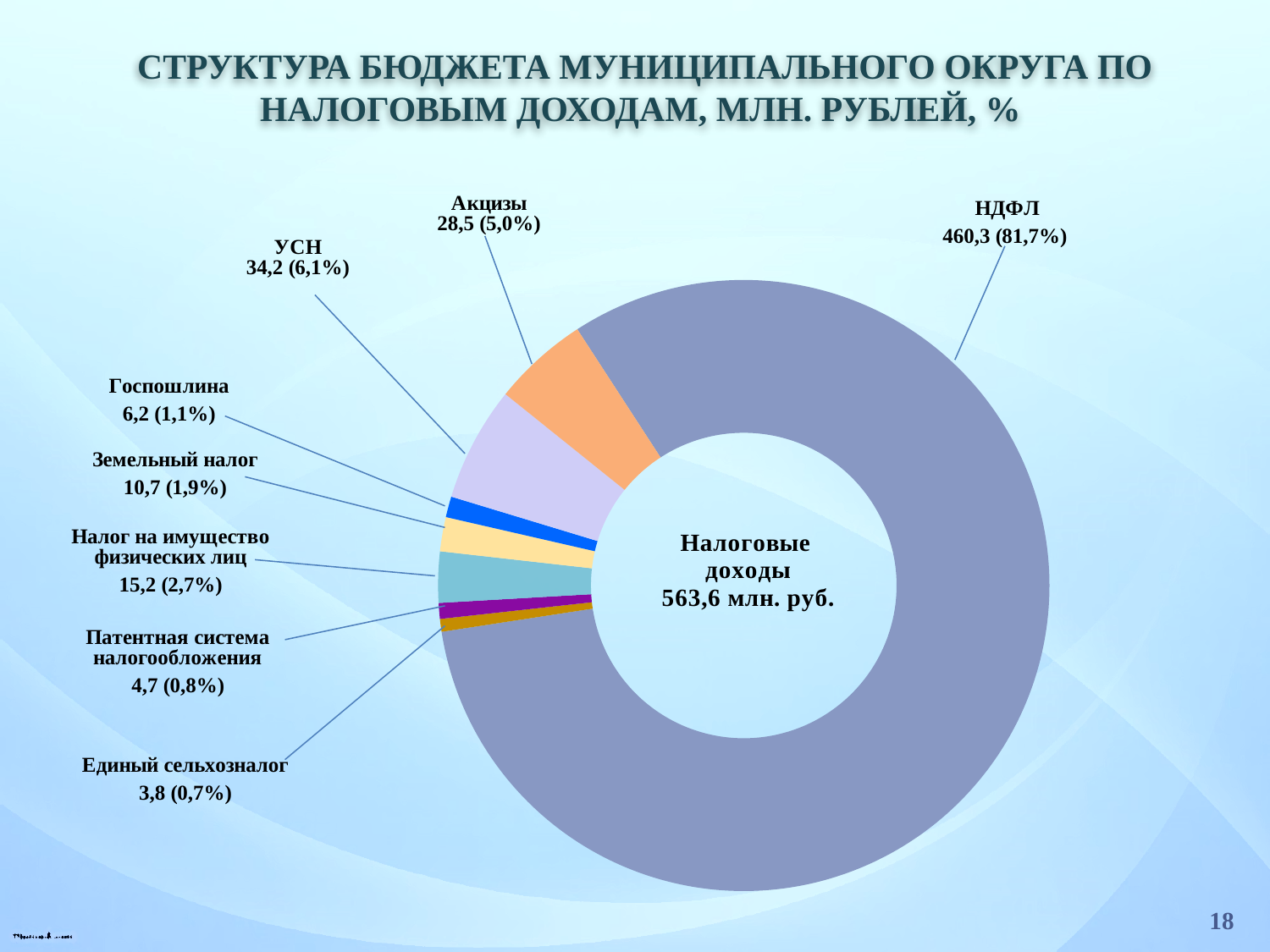
What value is shown for НДФЛ on the chart? 460,3 (81,7%) How many categories are shown on the chart? 8 Which category has the largest share of the chart? НДФЛ What value is shown for Земельный налог on the chart? 10,7 (1,9%) What share of the chart does Патентная система налогообложения represent? 0,8% What value is shown for УСН on the chart? 34,2 (6,1%) Which category has the smallest share of the chart? Единый сельхозналог What share of the chart does Налог на имущество физических лиц represent? 2,7% What is the difference in млн. рублей between УСН and Акцизы? 5,7 What kind of chart is shown on the slide? Doughnut chart Which is larger, УСН or Акцизы? УСН What value is shown for Акцизы on the chart? 28,5 (5,0%)